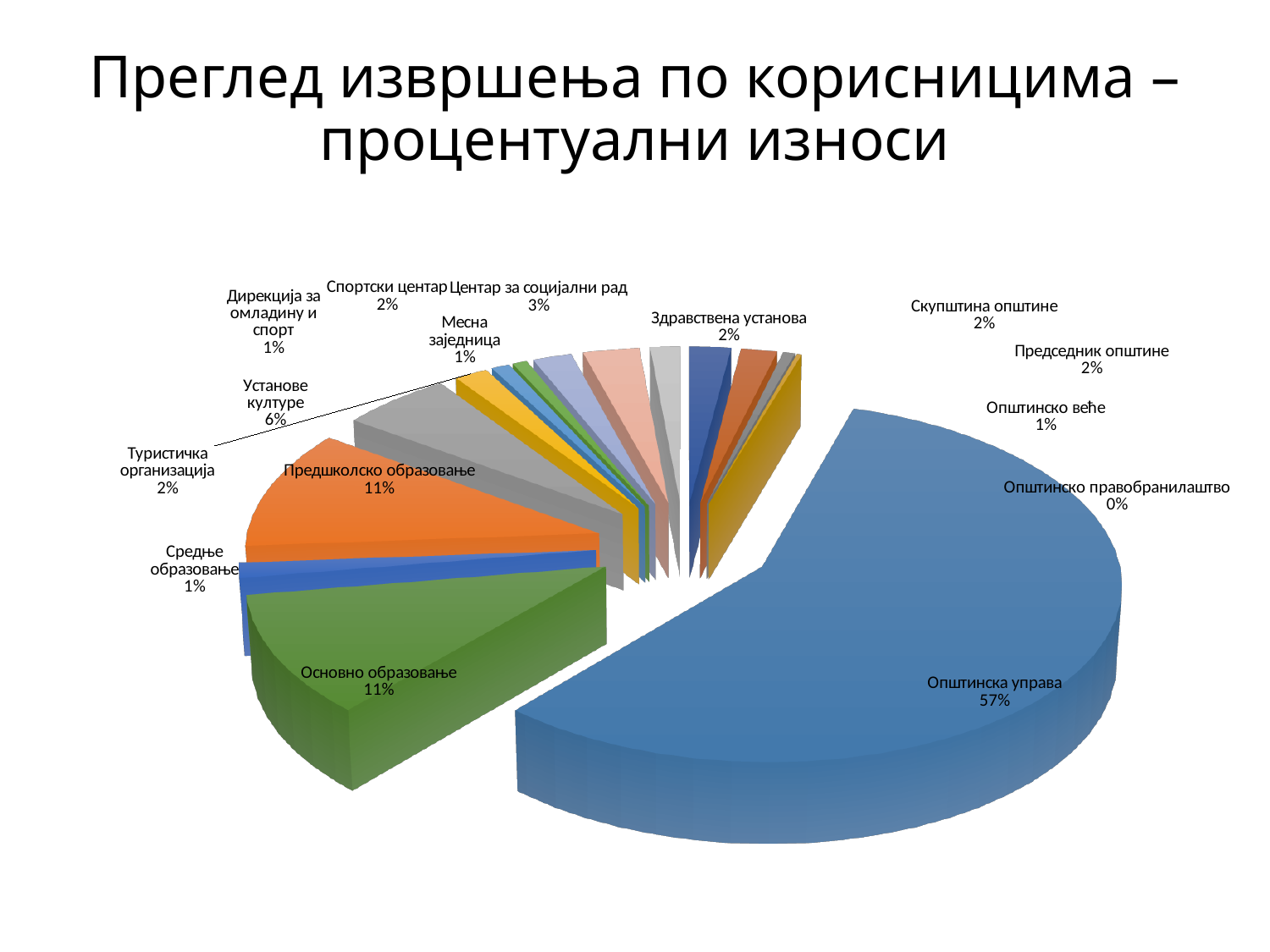
Which category has the smallest share of the pie? Општинско правобранилаштво What percentage is shown for Основно образовање? 11% What percentage is shown for Центар за социјални рад? 3% What kind of chart is shown on the slide? pie chart What is the difference in percentage points between Установе културе and Средње образовање? 5 What share of the pie does Општинска управа have? 57% How many categories are shown in the pie chart? 15 Which category has the largest share of the pie? Општинска управа What percentage is shown for Установе културе? 6% Which is larger, the share for Установе културе or the share for Центар за социјални рад? Установе културе What is the title of the slide? Преглед извршења по корисницима – процентуални износи What is the difference in percentage points between Општинска управа and Предшколско образовање? 46